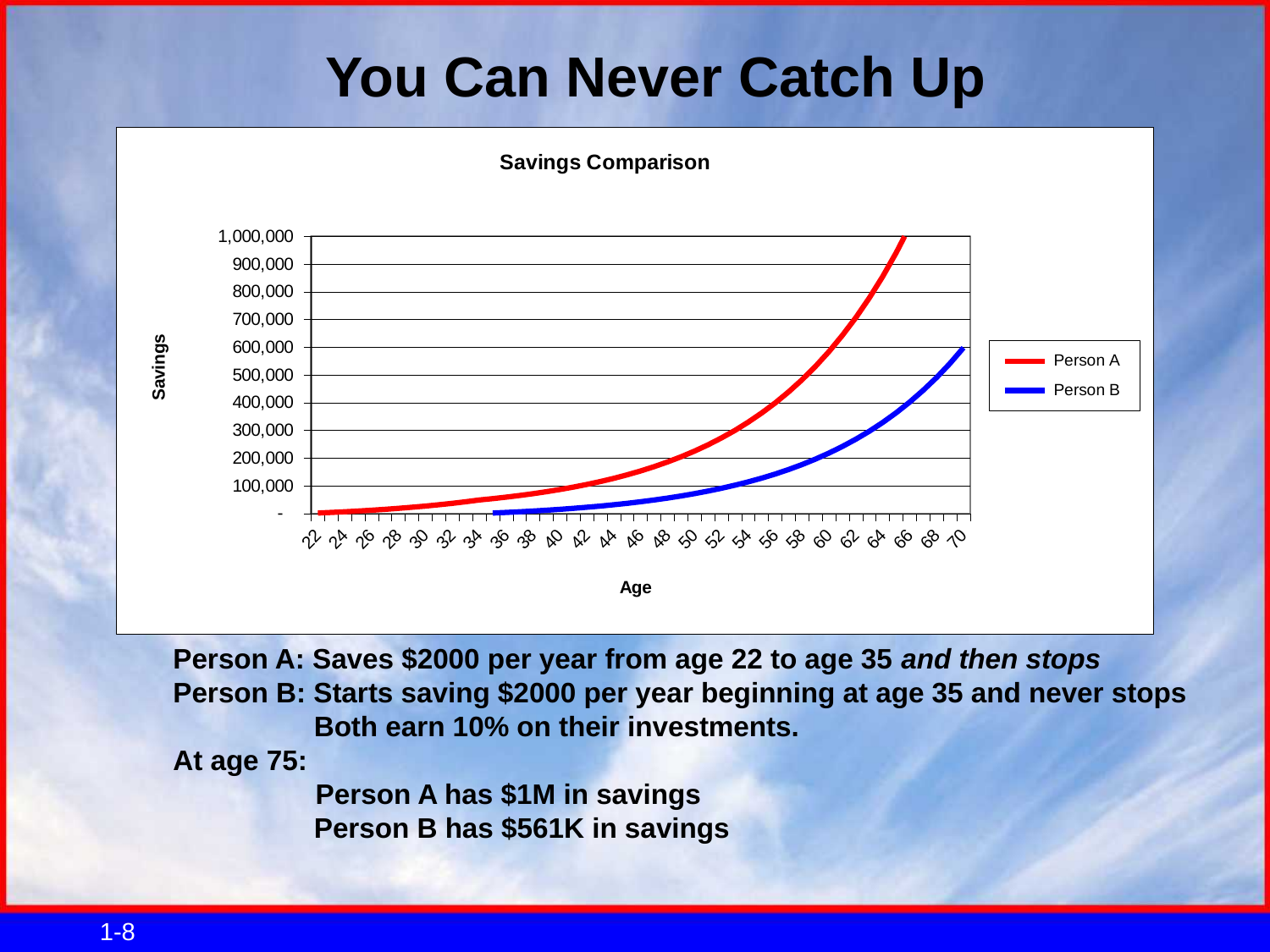
Is the value for Person A at age 50 greater or less than 100,000? greater What kind of chart is shown on the slide? line chart Is the value for Person A at age 64 greater or less than 700,000? greater What is the title of the chart? Savings Comparison Is the value for Person B at age 50 greater or less than 100,000? less What colour is the line for Person A? red At age 60, which series has the higher savings value, Person A or Person B? Person A Which series reaches the highest savings value on the chart? Person A How many age labels are shown along the x axis? 25 How many series does the chart legend list? 2 Do the savings values for Person B rise or fall as age increases along the x axis? rise